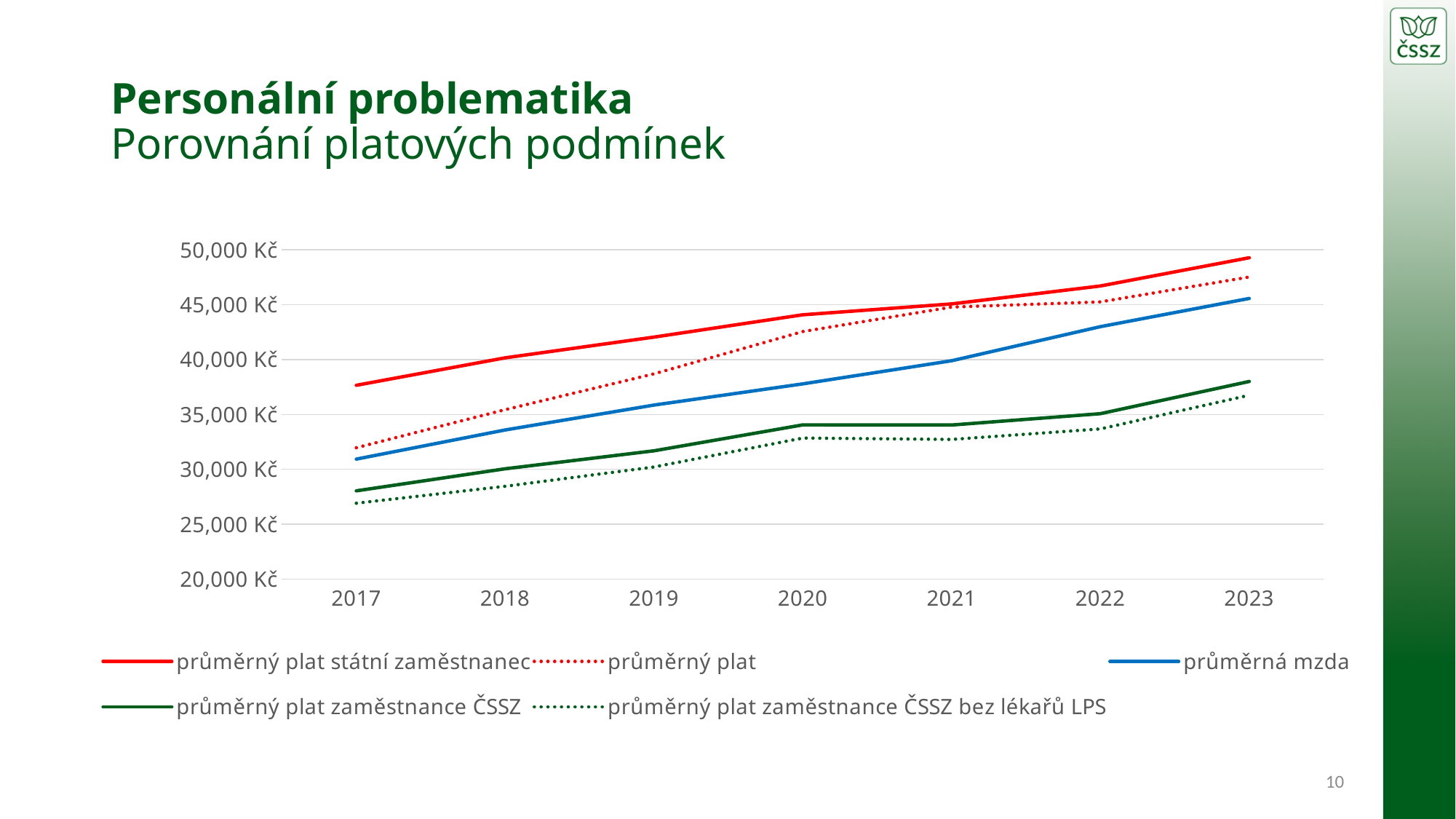
Is the value for průměrný plat in 2017 greater or less than 35,000 Kč? less Which series has the highest value in 2017? průměrný plat státní zaměstnanec Is the value for průměrný plat státní zaměstnanec in 2023 greater or less than 45,000 Kč? greater How many years are shown on the x axis? 7 What colour is the line for průměrná mzda? blue Does the value for průměrná mzda rise or fall from 2017 to 2023? rise What kind of chart is shown on the slide? line chart In 2020, which is larger: průměrný plat or průměrná mzda? průměrný plat How many series does the legend list? 5 Is the value for průměrný plat zaměstnance ČSSZ in 2017 greater or less than 30,000 Kč? less Which series has the lowest value in 2023? průměrný plat zaměstnance ČSSZ bez lékařů LPS In 2023, which is larger: průměrná mzda or průměrný plat zaměstnance ČSSZ? průměrná mzda